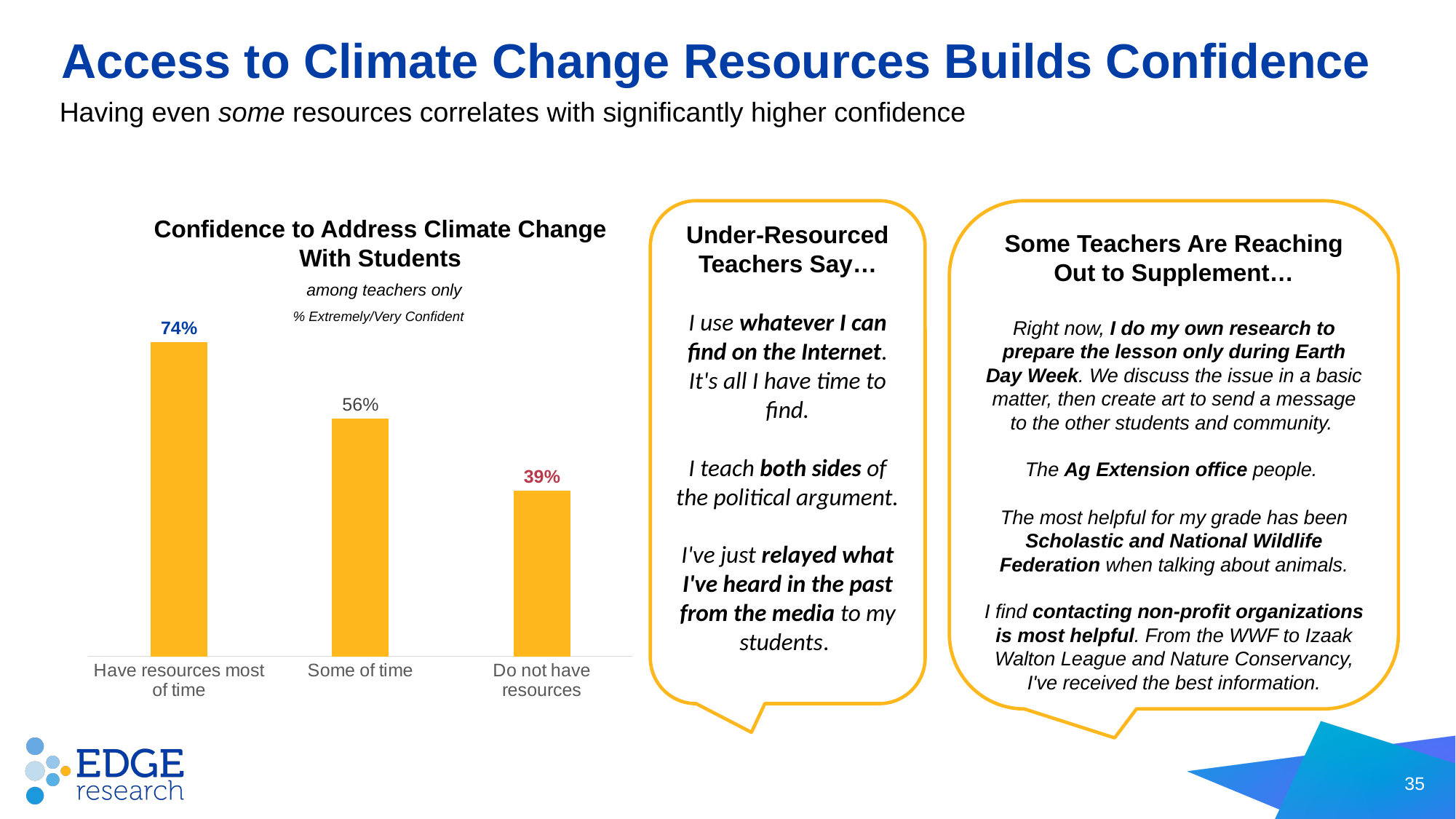
What percentage is shown for teachers who do not have resources? 39% What type of chart is used to show confidence to address climate change? Bar chart Which category has the highest confidence value? Have resources most of time What is the title of the chart? Confidence to Address Climate Change With Students What is the difference in percentage points between 'Have resources most of time' and 'Do not have resources'? 35 percentage points Which is larger: the value for 'Some of time' or the value for 'Do not have resources'? Some of time Do the values rise or fall moving from left to right across the categories? Fall Which category has the lowest confidence value? Do not have resources What is the value shown for the 'Some of time' category? 56% What percentage of teachers who have resources most of the time are extremely/very confident to address climate change with students? 74% How many categories are shown in the chart? 3 What is the difference between the 'Some of time' value and the 'Do not have resources' value? 17 percentage points